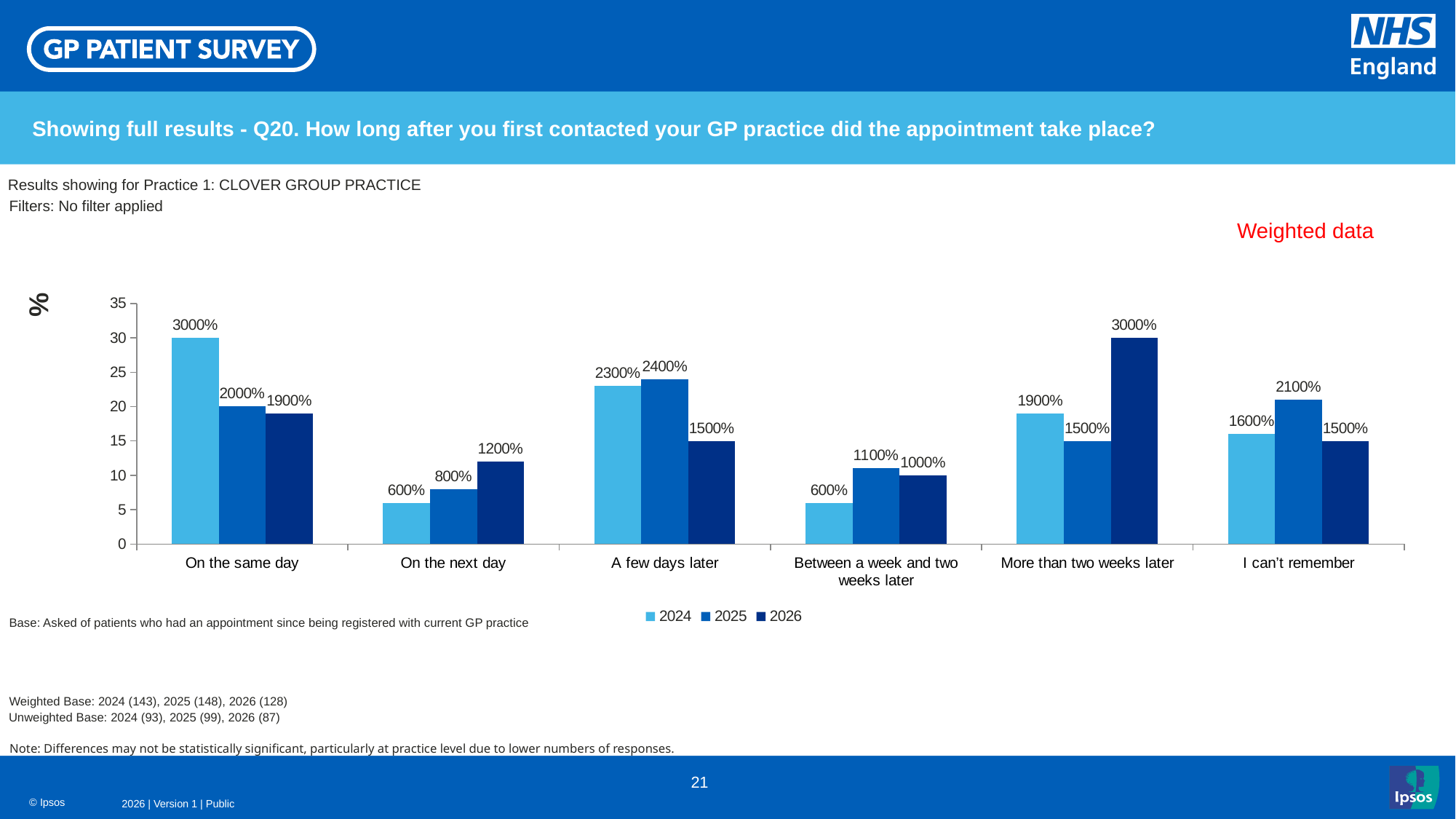
Which category has the lowest value for the 2025 series? On the next day How many categories are shown on the x axis? 6 In the 'On the next day' category, do the values rise or fall from 2024 to 2026? Rise What is the data label for 2026 in the 'More than two weeks later' category? 3000% What is the data label for 2026 in the 'I can't remember' category? 1500% What is the data label for 2024 in the 'On the same day' category? 3000% Which category has the highest value for the 2026 series? More than two weeks later What is the data label for 2025 in the 'A few days later' category? 2400% How many series does the legend list? 3 What is the difference between the 2026 and 2024 data labels in the 'On the next day' category? 600% In the 'Between a week and two weeks later' category, which series has the larger value, 2025 or 2026? 2025 What kind of chart is shown on the slide? Bar chart